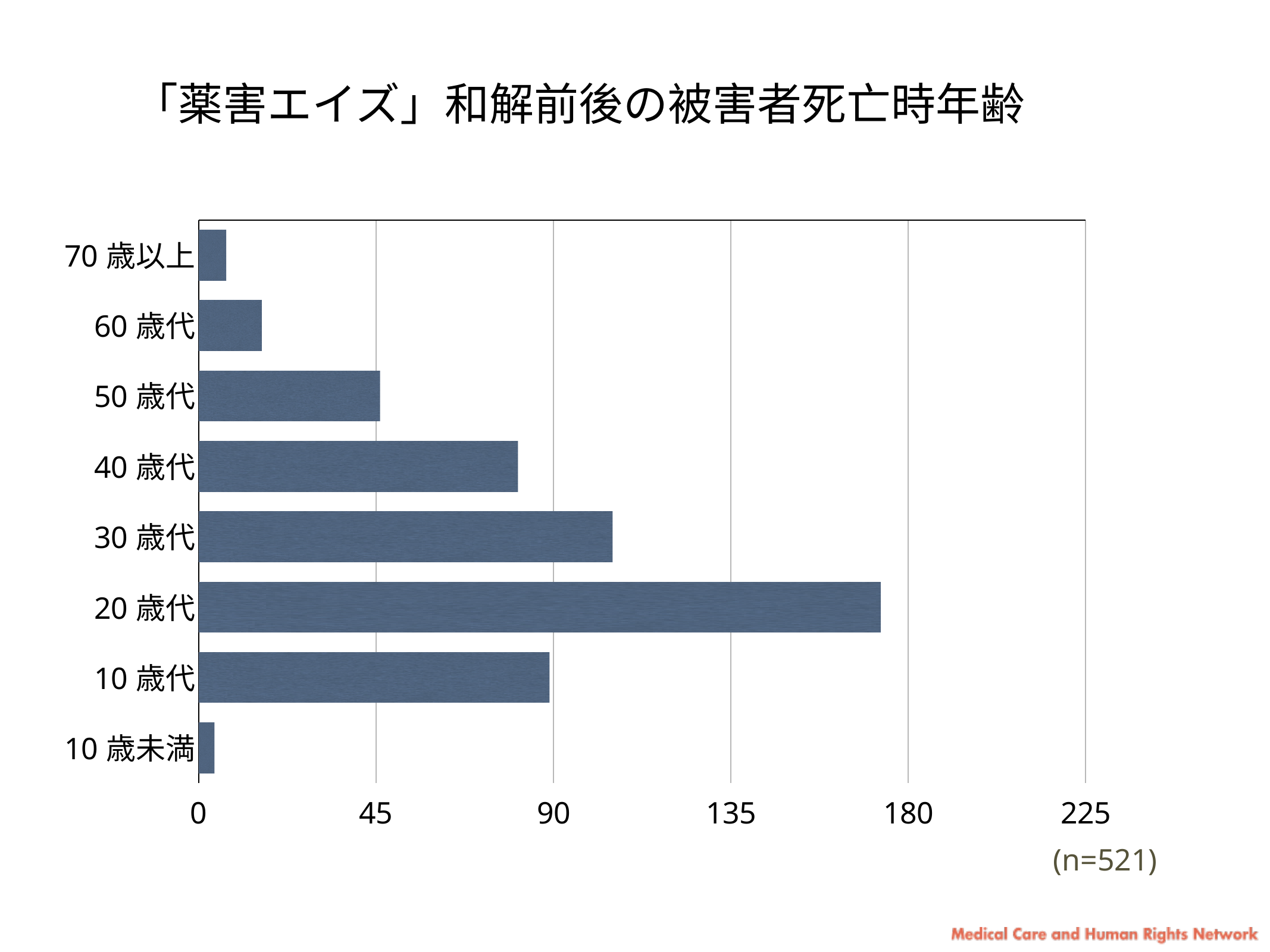
Is the value for 20 歳代 greater or less than 135? greater What sample size (n) is noted on the slide? n=521 How many age categories are shown on the chart? 8 Is the value for 40 歳代 greater or less than 90? less Is the value for 60 歳代 greater or less than 45? less What is the title of the chart? 「薬害エイズ」和解前後の被害者死亡時年齢 What kind of chart is shown on the slide? bar chart Which age category has the lowest value? 10 歳未満 Which is larger, the value for 30 歳代 or the value for 40 歳代? 30 歳代 Which age category has the highest value? 20 歳代